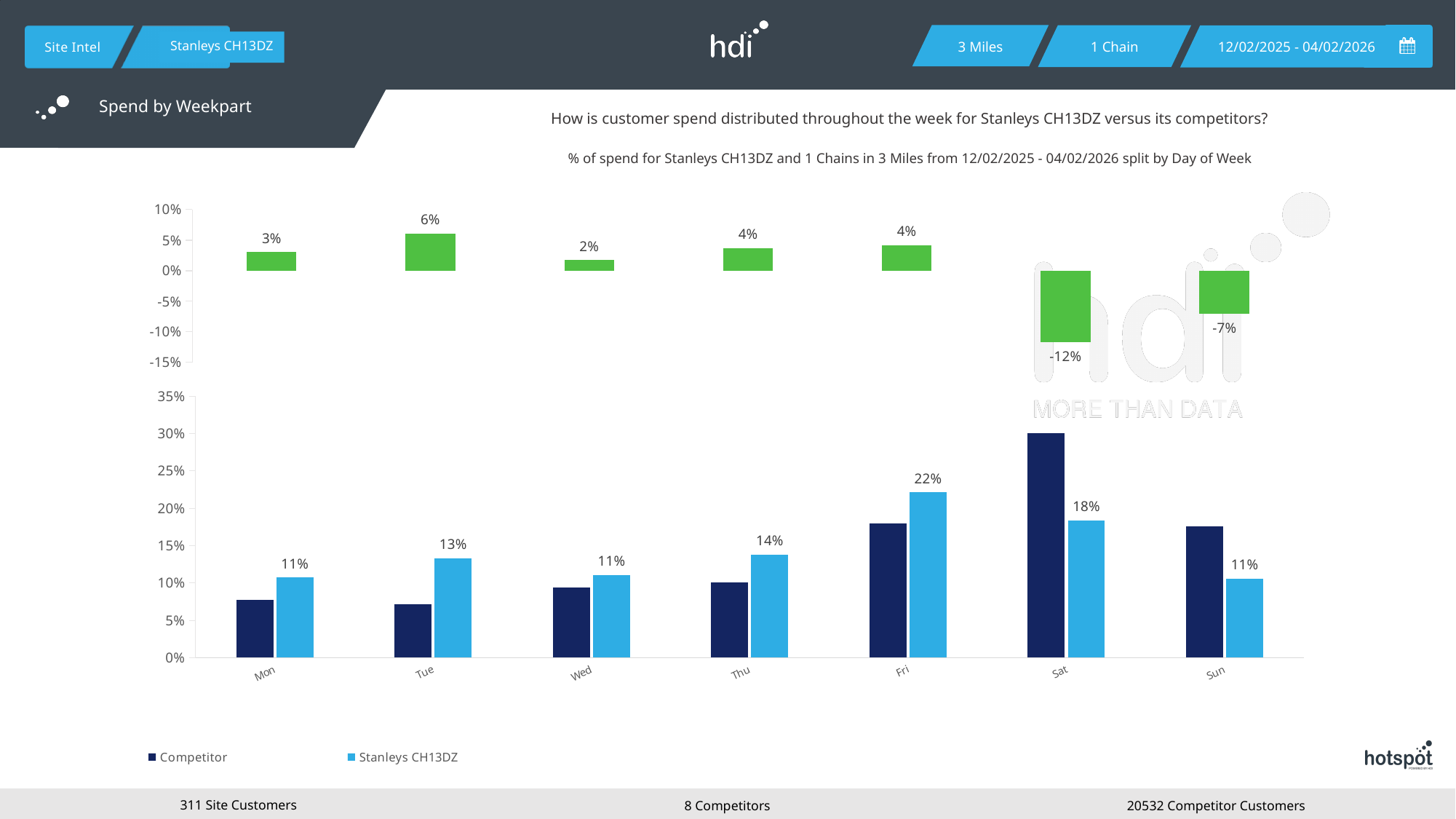
In the bottom chart, is the Competitor value for Tue greater or less than 10%? less In the bottom chart, on which day is the Stanleys CH13DZ value highest? Fri In the bottom chart, what is the value for Stanleys CH13DZ on Thu? 14% How many series does the legend of the bottom chart list? 2 In the bottom chart, on Sat, which is larger: the Competitor value or the Stanleys CH13DZ value? Competitor In the bottom chart, what is the difference between the Stanleys CH13DZ values for Fri and Sat? 4% What kind of chart is the bottom chart? bar chart In the bottom chart, what is the value for Stanleys CH13DZ on Fri? 22% In the bottom chart, is the Competitor value for Sat greater or less than 25%? greater How many days of the week are shown on the x axis of the bottom chart? 7 In the bottom chart, on which day is the Competitor value highest? Sat In the top chart, what is the lowest value shown? -12%